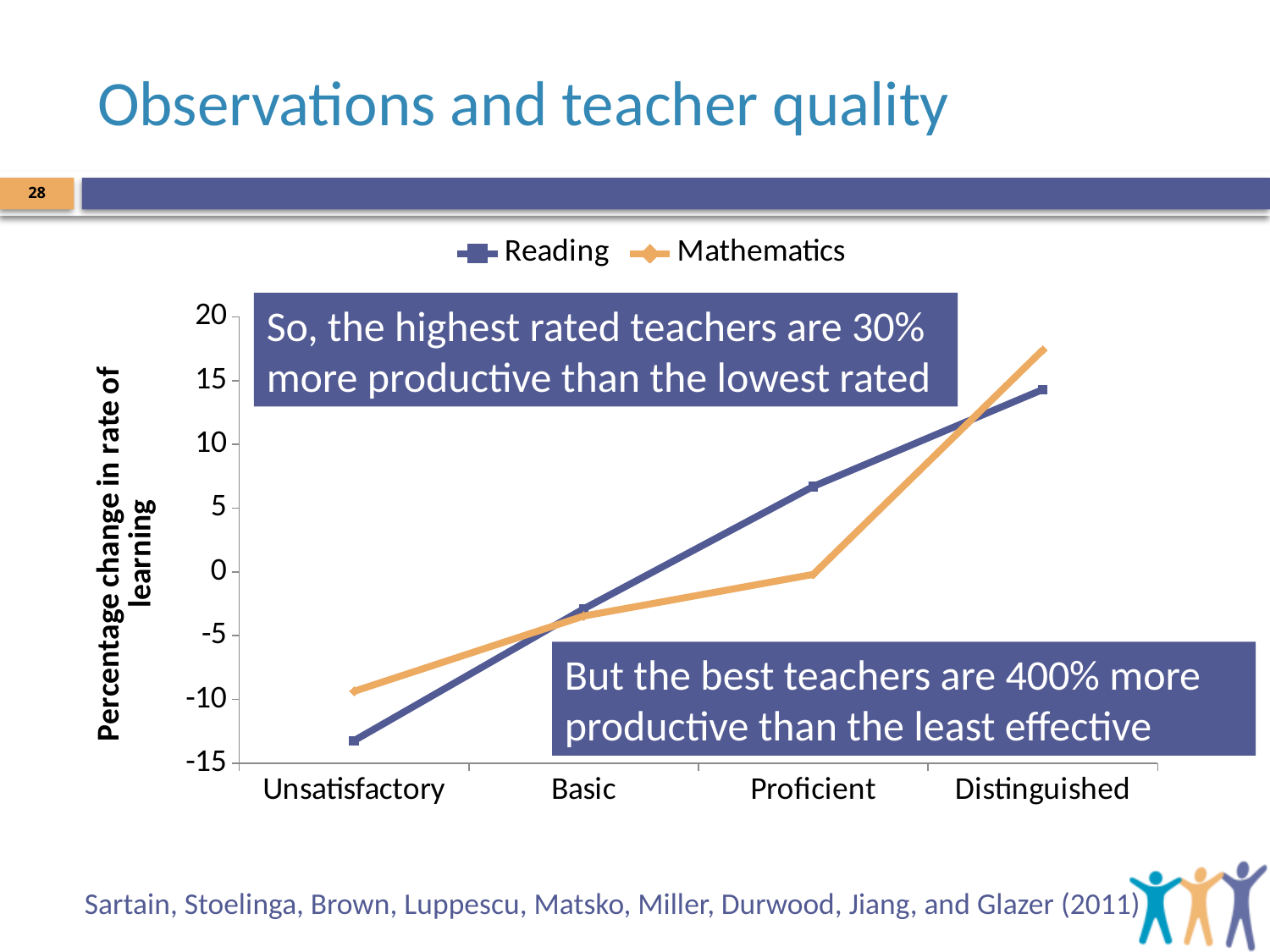
At Proficient, which series has the larger value, Reading or Mathematics? Reading For which category is the Mathematics value lowest? Unsatisfactory For which category is the Reading value highest? Distinguished How many series does the legend list? 2 Is the Reading value for Proficient greater or less than 5? greater Is the Reading value for Unsatisfactory greater or less than -10? less What kind of chart is shown on the slide? line chart How many categories are shown on the x axis? 4 Does the Reading series rise or fall from Unsatisfactory to Distinguished? rise At Distinguished, which series has the larger value, Reading or Mathematics? Mathematics Is the Mathematics value for Distinguished greater or less than 15? greater What is the label on the y axis of the chart? Percentage change in rate of learning